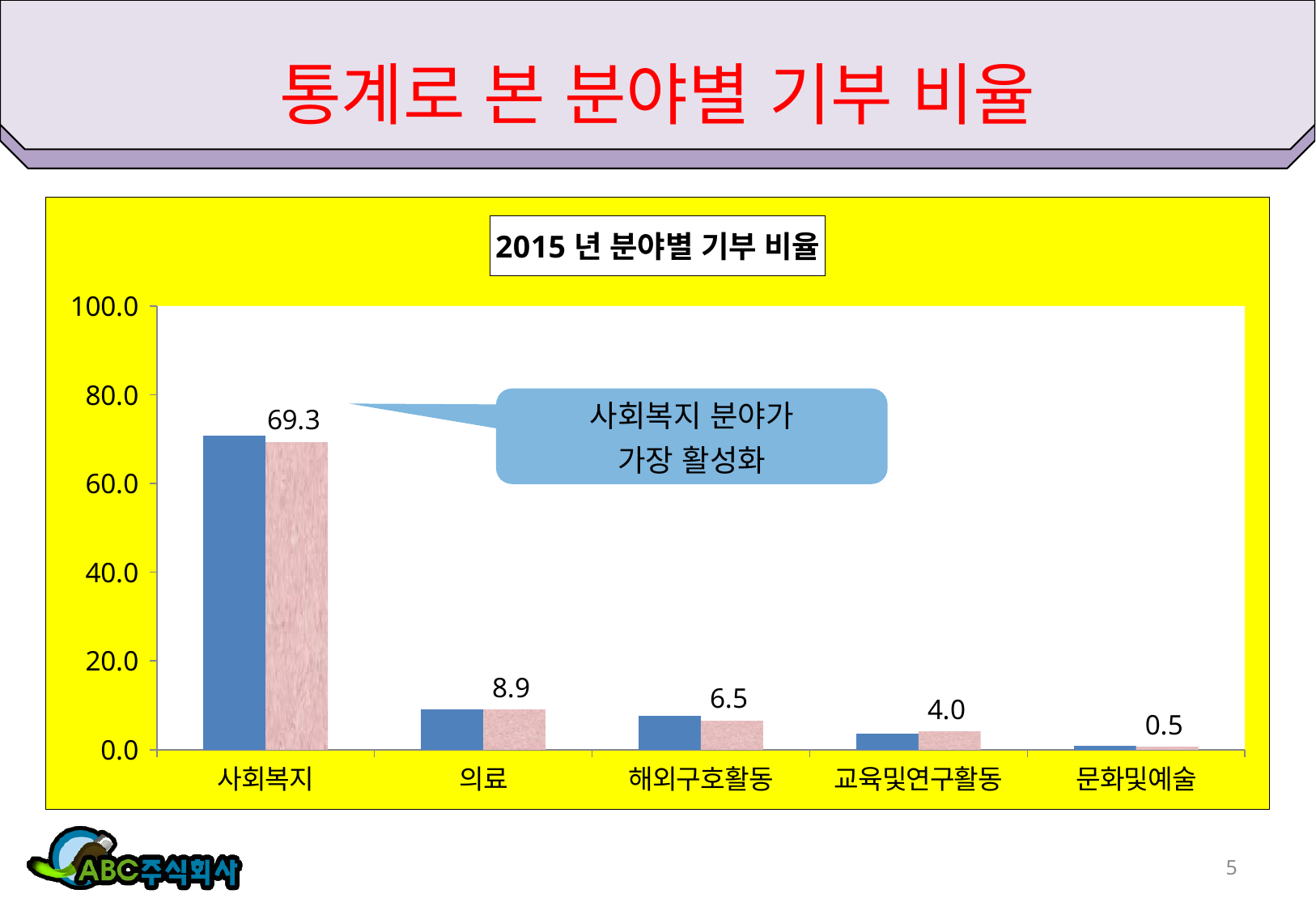
What is the labelled value for 사회복지? 69.3 Which category has the highest value? 사회복지 What is the difference between the labelled values for 사회복지 and 의료? 60.4 What is the labelled value for 해외구호활동? 6.5 What is the labelled value for 문화및예술? 0.5 What type of chart is shown on the slide? bar chart Which is larger, the value for 교육및연구활동 or the value for 해외구호활동? 해외구호활동 What is the labelled value for 의료? 8.9 Which category has the lowest value? 문화및예술 What is the title of the chart? 2015 년 분야별 기부 비율 How many categories are shown on the x axis of the chart? 5 Do the values rise or fall from left to right along the x axis? fall